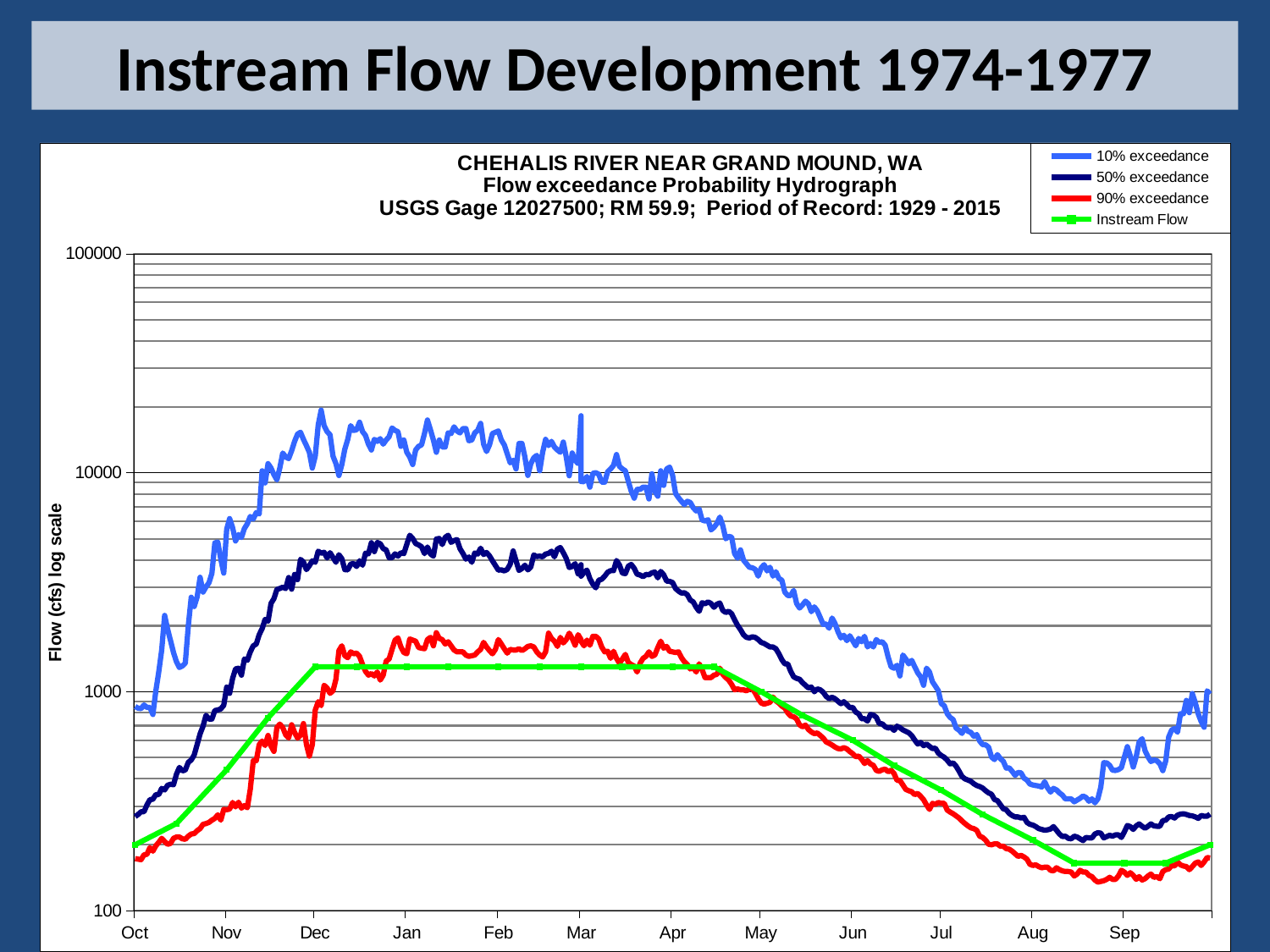
Which series has the highest value in January? 10% exceedance How many series does the legend list? 4 Is the Instream Flow value in February greater or less than 1000? greater Is the 90% exceedance value in August greater or less than 1000? less How many months are labelled along the x axis? 12 What period of record is stated in the chart title? 1929 - 2015 Is the 10% exceedance value in January greater or less than 10000? greater Which series is plotted in green? Instream Flow Does the 10% exceedance line rise or fall from January to August? fall Which series has the lowest value in August? 90% exceedance What kind of chart is shown on the slide? line chart